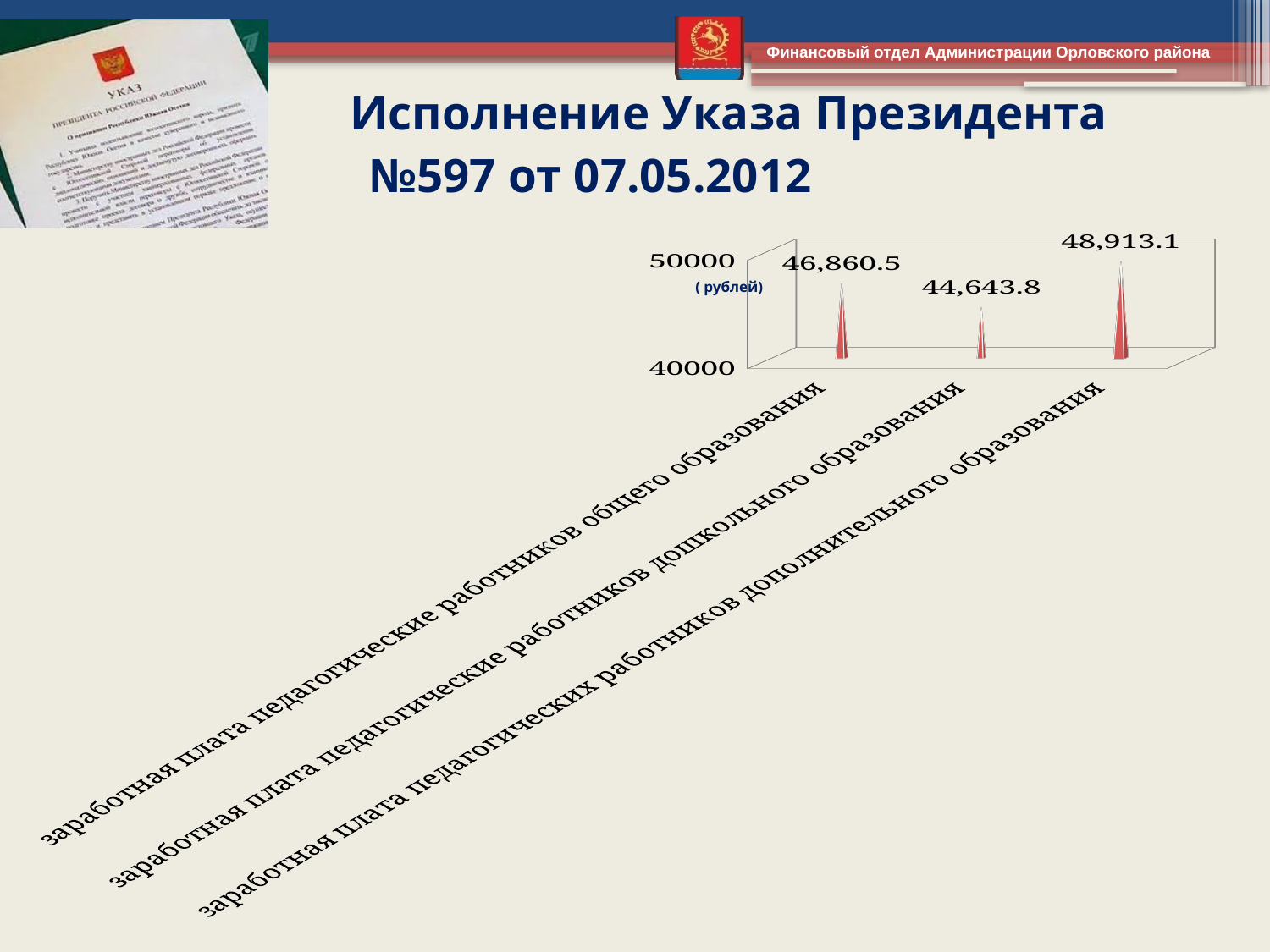
What is the difference between the value for дополнительного образования and the value for общего образования? 2,052.6 Which category has the lowest value? заработная плата педагогические работников дошкольного образования What is the value for заработная плата педагогических работников дополнительного образования? 48,913.1 What is the value for заработная плата педагогические работников дошкольного образования? 44,643.8 What is the value for заработная плата педагогические работников общего образования? 46,860.5 What is the maximum value shown on the vertical axis of the chart? 50000 Which category has the highest value? заработная плата педагогических работников дополнительного образования What is the difference between the value for общего образования and the value for дошкольного образования? 2,216.7 What unit is indicated on the chart's value axis? рублей Which is larger: the value for общего образования or the value for дошкольного образования? общего образования What kind of chart is shown on the slide? bar chart How many categories are shown in the chart? 3